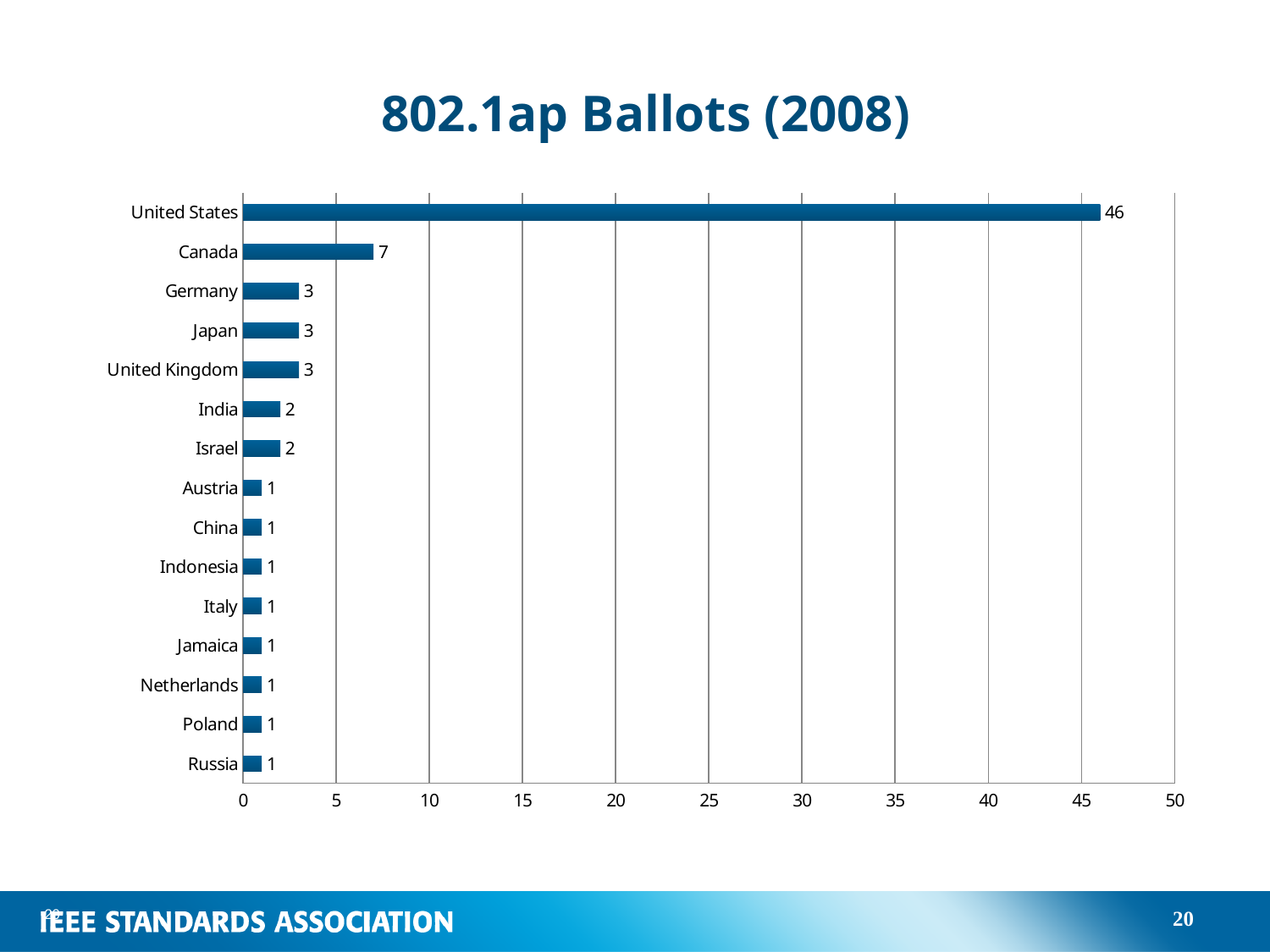
How many countries have a value of 1? 8 What is the title of the chart? 802.1ap Ballots (2008) What kind of chart is shown on the slide? bar chart What is the difference between the values for the United States and Canada? 39 How many countries are shown on the chart? 15 What is the value for the United States? 46 What is the difference between the values for Canada and Germany? 4 What is the value for India? 2 Which country has the highest value? United States Which is larger, the value for Japan or the value for Israel? Japan Is the value for the United States greater or less than 45? greater What is the value for Canada? 7